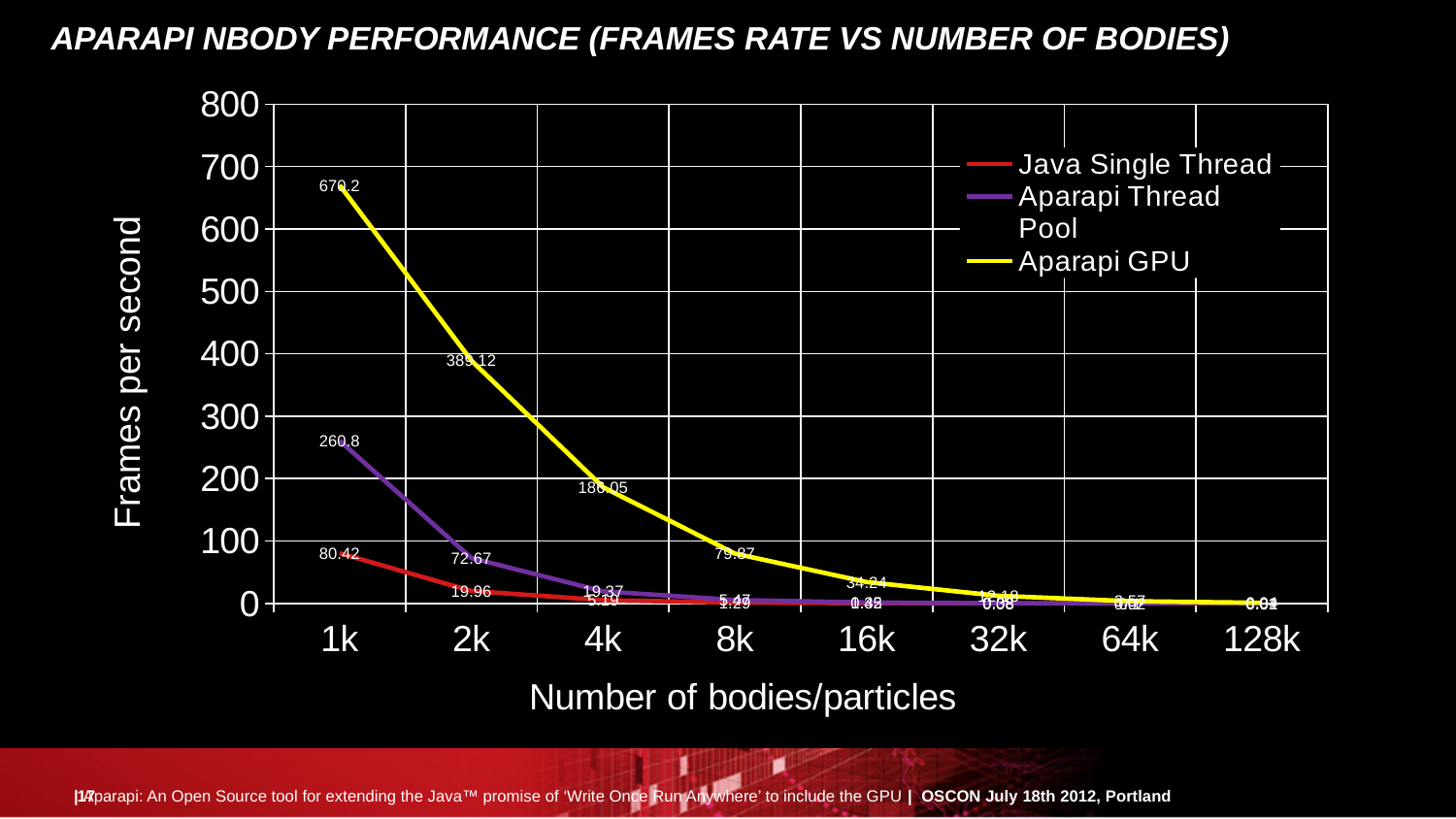
What kind of chart is shown on the slide? Line chart What is the frames per second value for Aparapi GPU at 1k bodies? 670.2 What is the difference between the Aparapi GPU and Aparapi Thread Pool values at 1k bodies? 409.4 How many series does the legend list? 3 What is the frames per second value for Java Single Thread at 1k bodies? 80.42 What is the frames per second value for Aparapi Thread Pool at 1k bodies? 260.8 At 2k bodies, which is larger: Aparapi Thread Pool or Java Single Thread? Aparapi Thread Pool How many body-count categories are shown on the x axis? 8 What is the frames per second value for Aparapi GPU at 2k bodies? 389.12 Is the Aparapi GPU value at 2k bodies greater or less than 300? greater Does the Aparapi GPU frame rate rise or fall as the number of bodies increases? Fall Which series has the highest frames per second at 1k bodies? Aparapi GPU